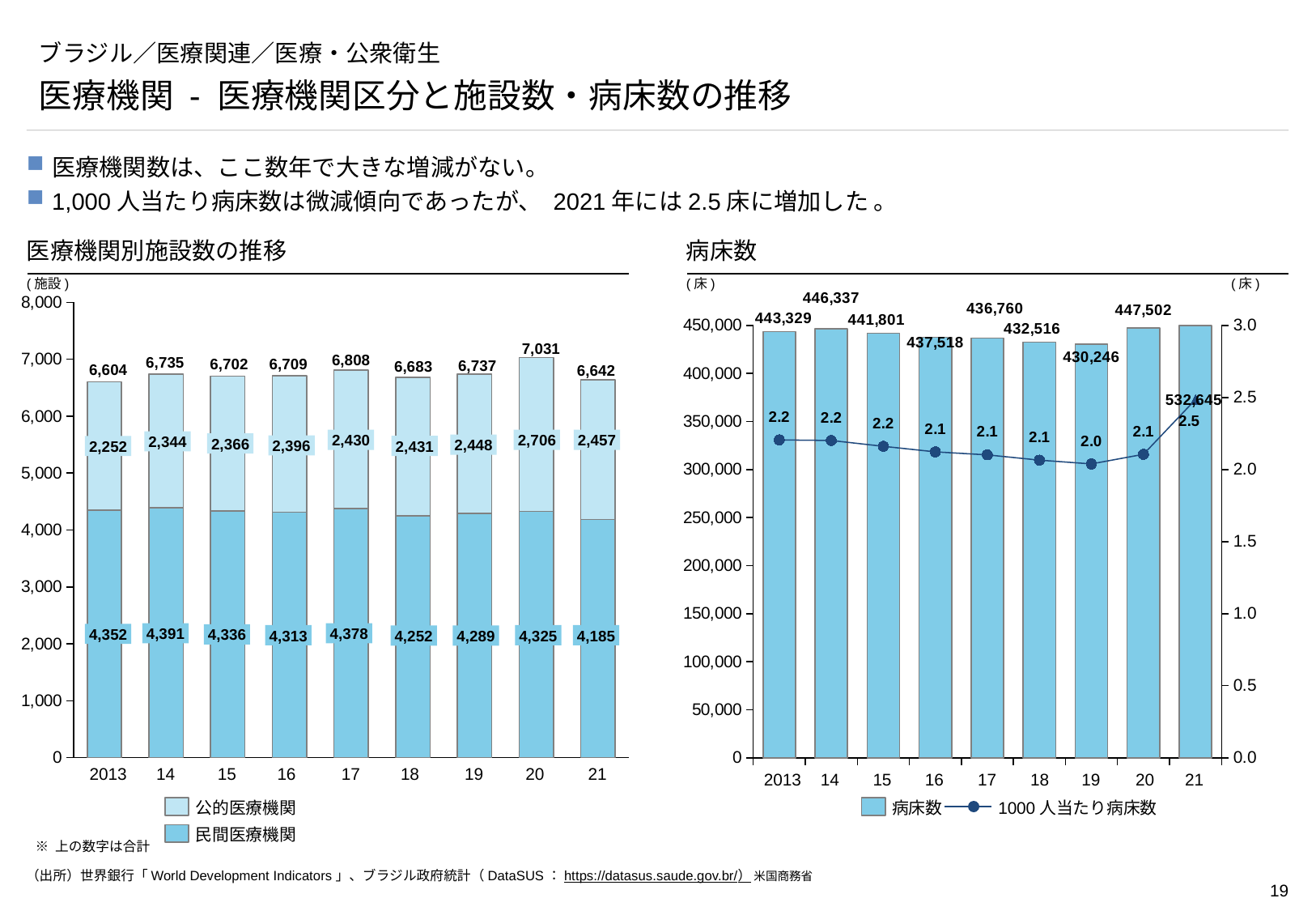
In the 医療機関別施設数の推移 chart, what is the difference between the 民間医療機関 values for 14 and 21? 206 In the 医療機関別施設数の推移 chart, what is the total of the stacked bar for 17? 6,808 In the 病床数 chart, which year has the lowest 1000人当たり病床数? 19 In the 医療機関別施設数の推移 chart, which year has the highest total number of facilities? 20 What kind of chart is the 医療機関別施設数の推移 chart? Stacked bar chart In the 病床数 chart, what is the number of beds (病床数) in 19? 430,246 In the 医療機関別施設数の推移 chart, how many series does the legend list? 2 In the 医療機関別施設数の推移 chart, what is the value for 公的医療機関 in 20? 2,706 In the 病床数 chart, how many years are shown on the x axis? 9 In the 医療機関別施設数の推移 chart, what is the value for 民間医療機関 in 2013? 4,352 In the 病床数 chart, what is the value of 1000人当たり病床数 in 21? 2.5 In the 病床数 chart, which is larger, the 病床数 for 2013 or for 14? 14